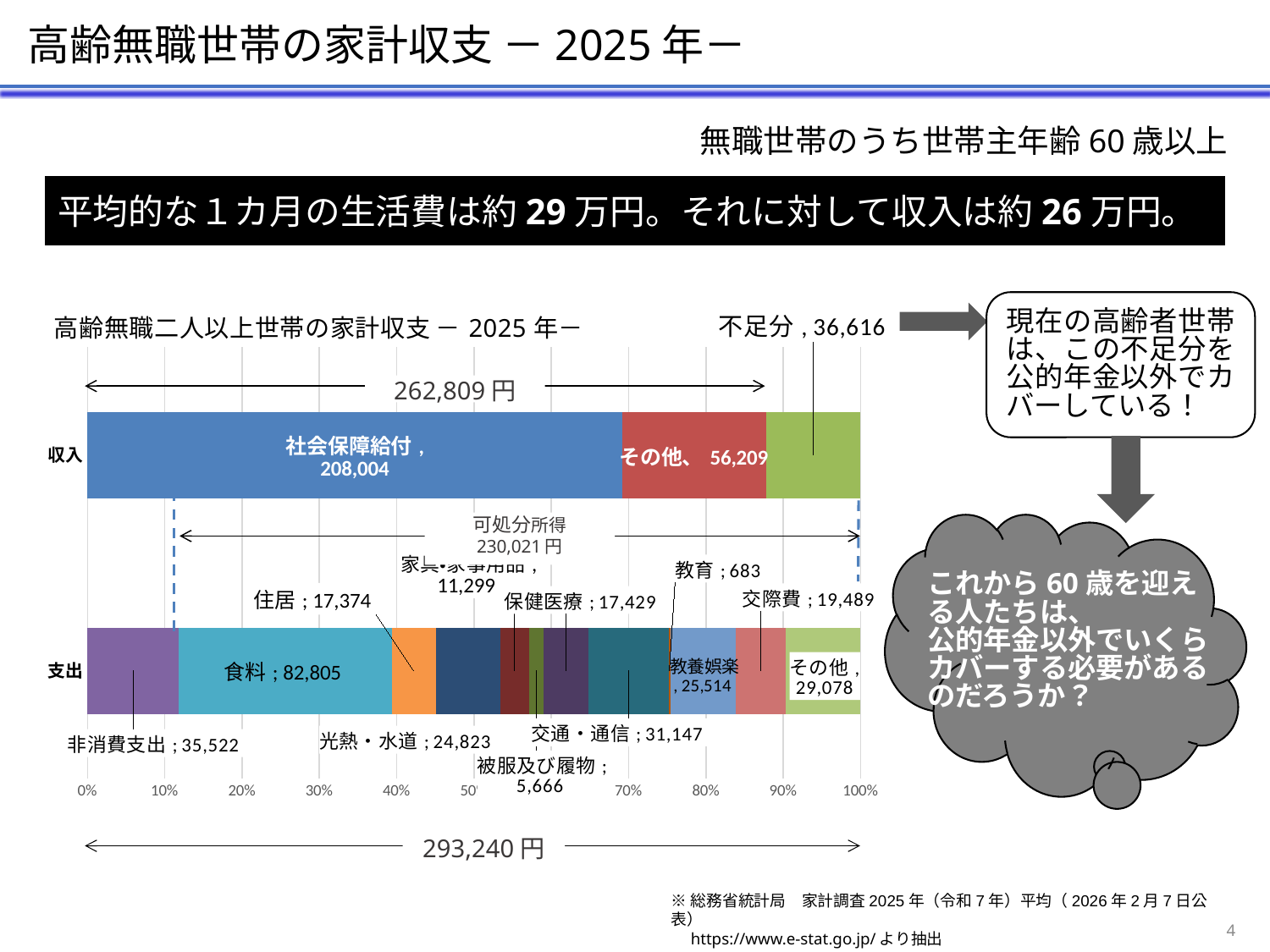
What is the value labelled 不足分? 36,616 How many segments make up the 支出 bar? 12 What is the difference between 社会保障給付 and その他 in the 収入 bar? 151,795 What total amount is shown by the arrow under the 支出 bar? 293,240円 What is the value of 可処分所得 shown on the chart? 230,021円 What kind of chart is shown on the slide? Stacked bar chart Which is larger in the 支出 bar, 光熱・水道 or 交際費? 光熱・水道 Which category in the 支出 bar has the smallest value? 教育 What is the value of 食料 in the 支出 bar? 82,805 What is the difference between 交通・通信 and 教養娯楽 in the 支出 bar? 5,633 Which category in the 支出 bar has the largest value? 食料 What is the value of 社会保障給付 in the 収入 bar? 208,004